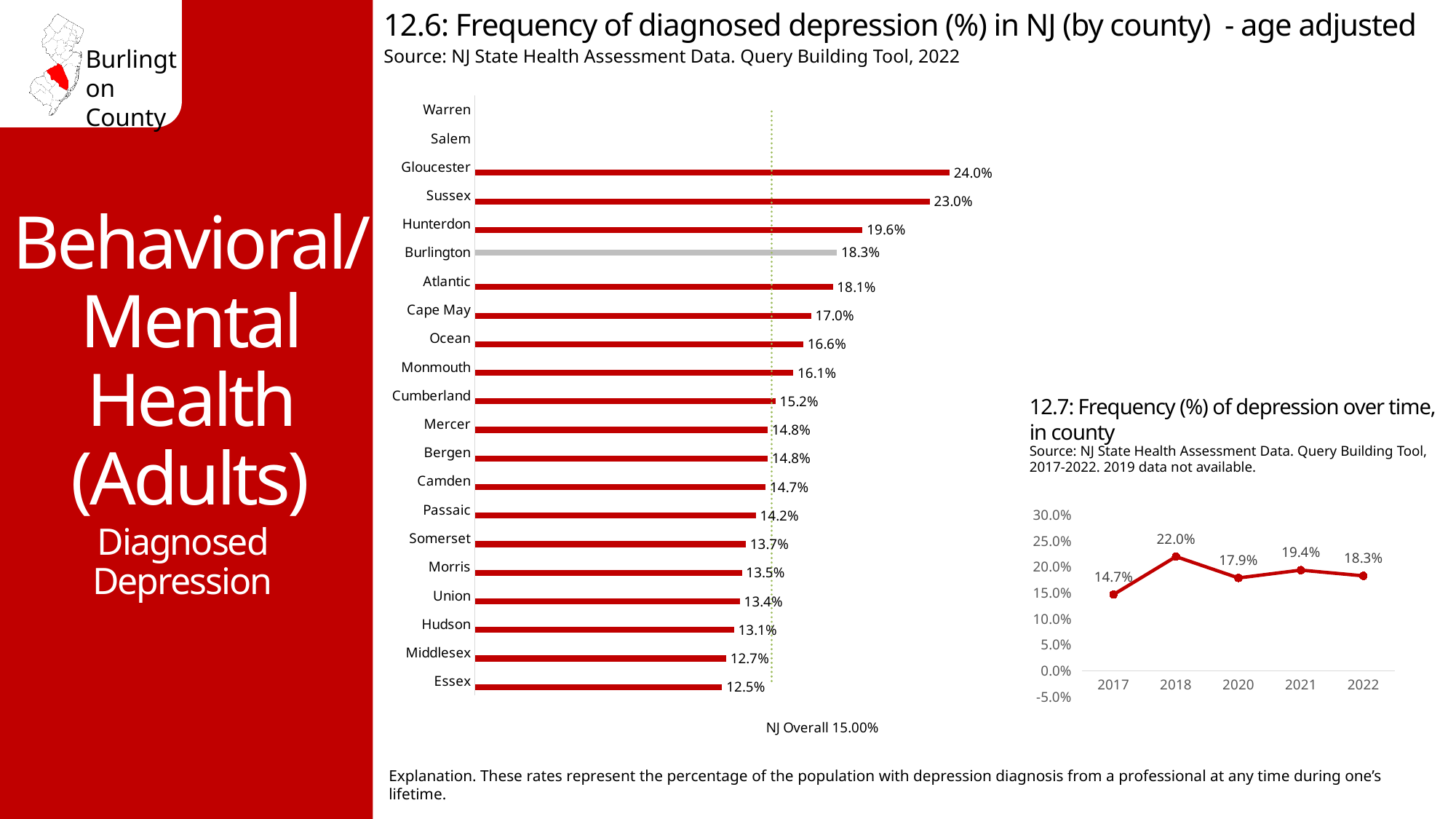
In chart 12.6 (frequency of diagnosed depression by county), what is the value for Burlington? 18.3% In chart 12.6 (frequency of diagnosed depression by county), which county has the highest value among those with a bar shown? Gloucester In chart 12.6 (frequency of diagnosed depression by county), what is the difference between Gloucester and Sussex? 1.0% In chart 12.7 (frequency of depression over time), which year has the lowest value? 2017 In chart 12.7 (frequency of depression over time), what is the value for 2018? 22.0% In chart 12.6 (frequency of diagnosed depression by county), which county has the lowest value among those with a bar shown? Essex In chart 12.6 (frequency of diagnosed depression by county), what is the NJ overall value noted below the chart? 15.00% In chart 12.7 (frequency of depression over time), what is the difference between the 2021 and 2022 values? 1.1% In chart 12.6 (frequency of diagnosed depression by county), which is larger, the value for Ocean or the value for Monmouth? Ocean In chart 12.7 (frequency of depression over time), how many data points are plotted? 5 In chart 12.6 (frequency of diagnosed depression by county), what is the value for Hunterdon? 19.6% What kind of chart is chart 12.6 (frequency of diagnosed depression by county)? Bar chart